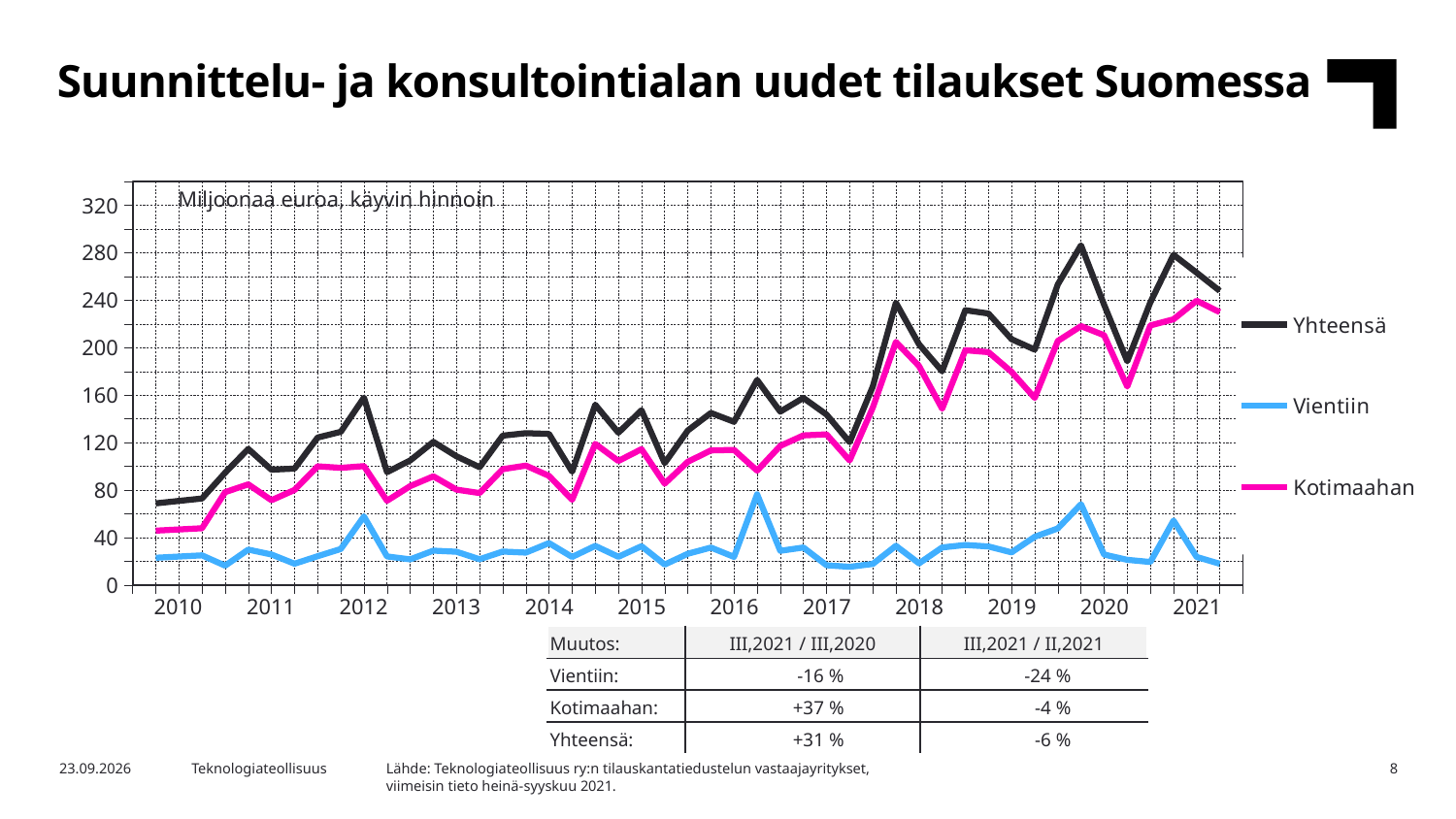
How many series does the legend list? 3 What kind of chart is shown on the slide? Line chart Does the Yhteensä series overall rise or fall from 2010 to 2021? rise In 2021, which is larger, Yhteensä or Vientiin? Yhteensä How many years are labelled on the x axis? 12 Which series has the highest values throughout the chart? Yhteensä Which series are listed in the legend? Yhteensä, Vientiin, Kotimaahan Which series has the lowest values throughout the chart? Vientiin Is the peak value for Vientiin in 2016 greater or less than 40? greater What unit label is printed inside the chart area? Miljoonaa euroa, käyvin hinnoin Is the value for Yhteensä at the start of 2010 greater or less than 80? less Is the value for Vientiin at the start of 2010 greater or less than 40? less